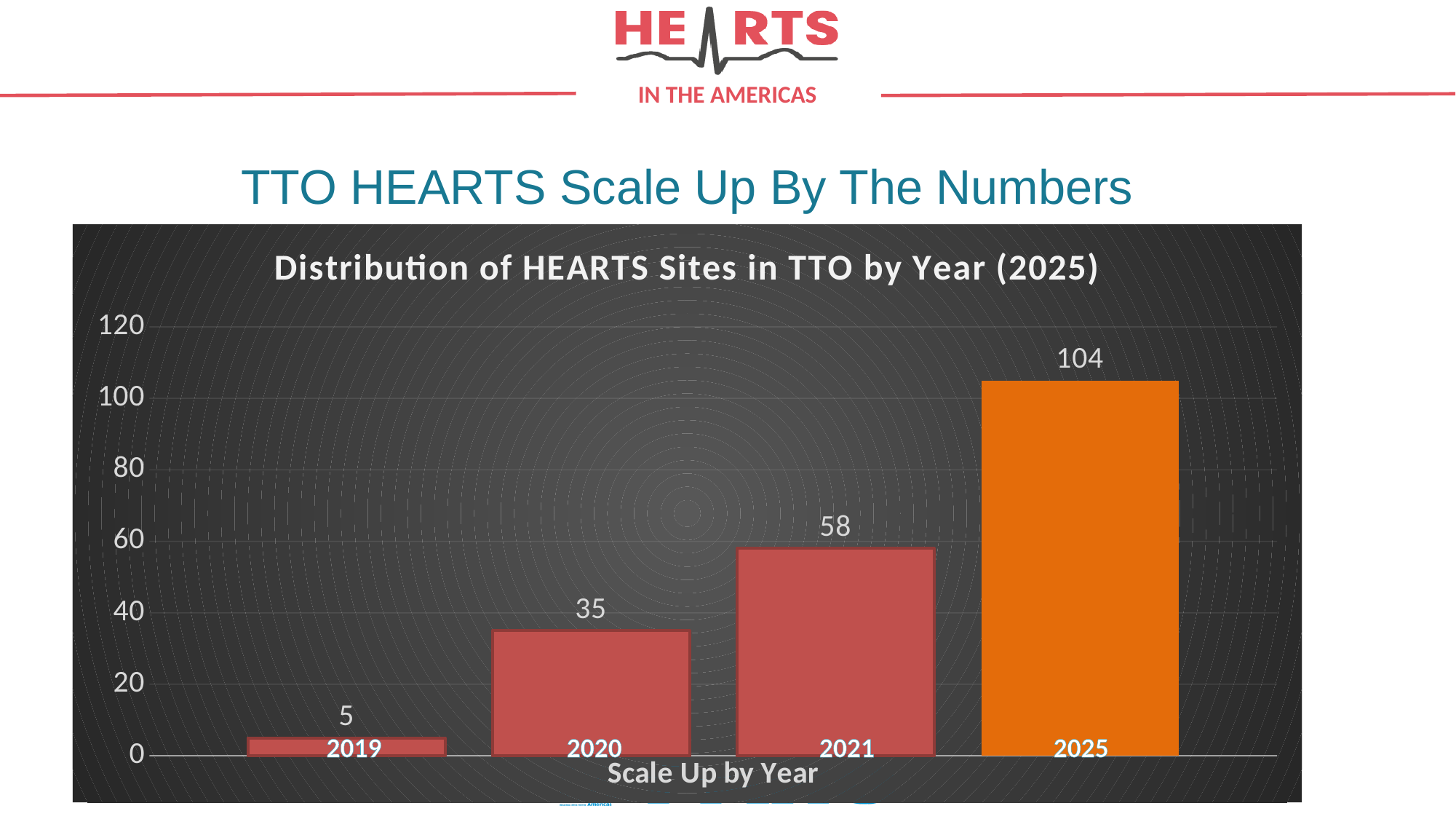
Which is larger, the value for 2020 or the value for 2021? 2021 What is the value for 2019? 5 Which year has the lowest value? 2019 What kind of chart is this? Bar chart What is the value for 2025? 104 What is the difference between the values for 2020 and 2019? 30 How many years are shown on the x axis? 4 Which year has the highest value? 2025 What is the title of the chart? Distribution of HEARTS Sites in TTO by Year (2025) What is the difference between the values for 2025 and 2021? 46 What is the value for 2020? 35 What is the value for 2021? 58